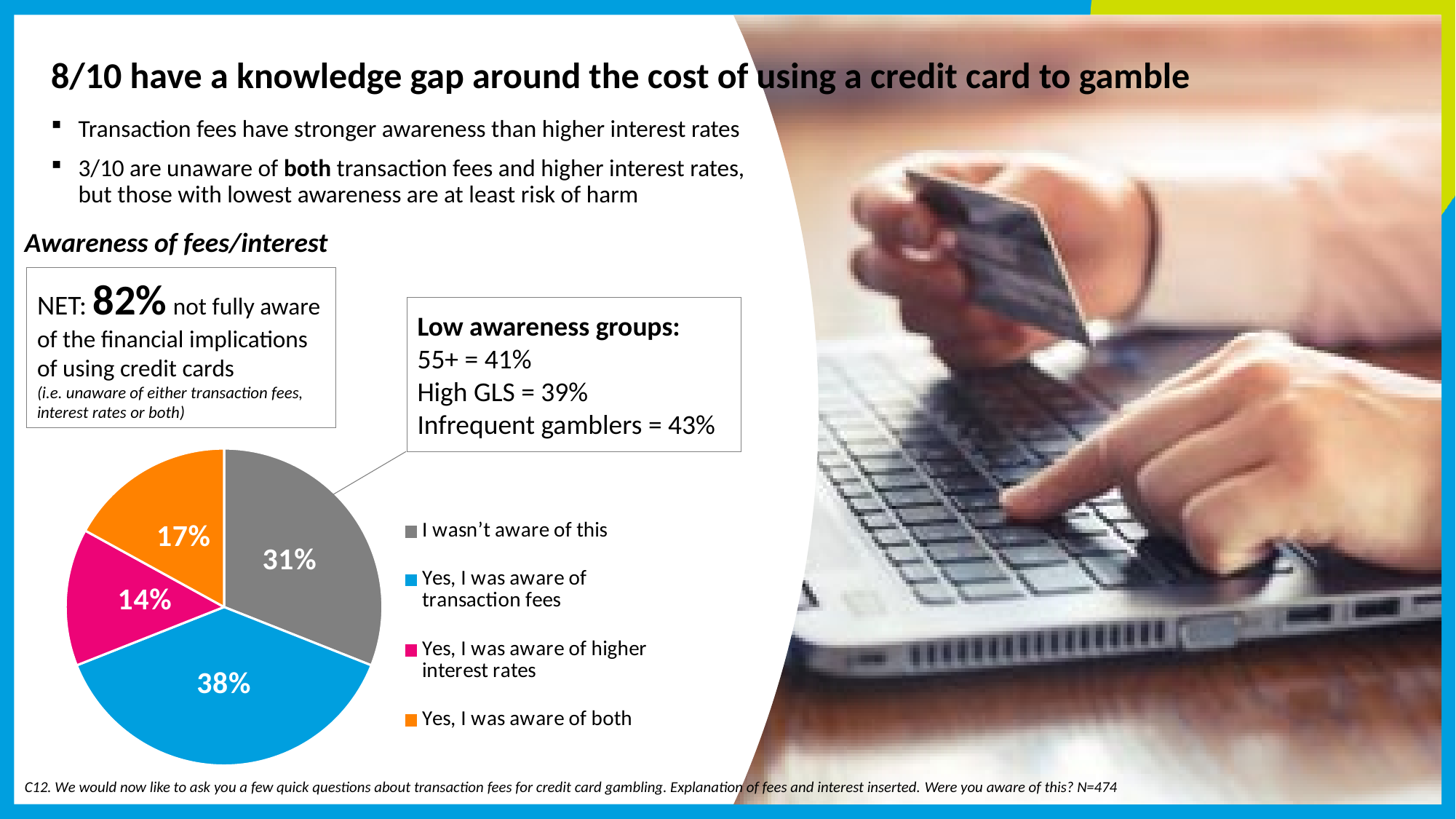
Which is larger: the share for "Yes, I was aware of both" or "Yes, I was aware of higher interest rates"? Yes, I was aware of both What percentage of respondents said "Yes, I was aware of both"? 17% What colour is the slice for "Yes, I was aware of transaction fees"? blue How many slices does the pie chart have? 4 What is the difference between the share for "Yes, I was aware of transaction fees" and "I wasn't aware of this"? 7% What percentage of respondents said "Yes, I was aware of transaction fees"? 38% What type of chart is shown on the slide? pie chart Which response has the largest share of the pie? Yes, I was aware of transaction fees What percentage of respondents said "I wasn't aware of this"? 31% Which response has the smallest share of the pie? Yes, I was aware of higher interest rates What percentage of respondents said "Yes, I was aware of higher interest rates"? 14% What is the title of the chart? Awareness of fees/interest